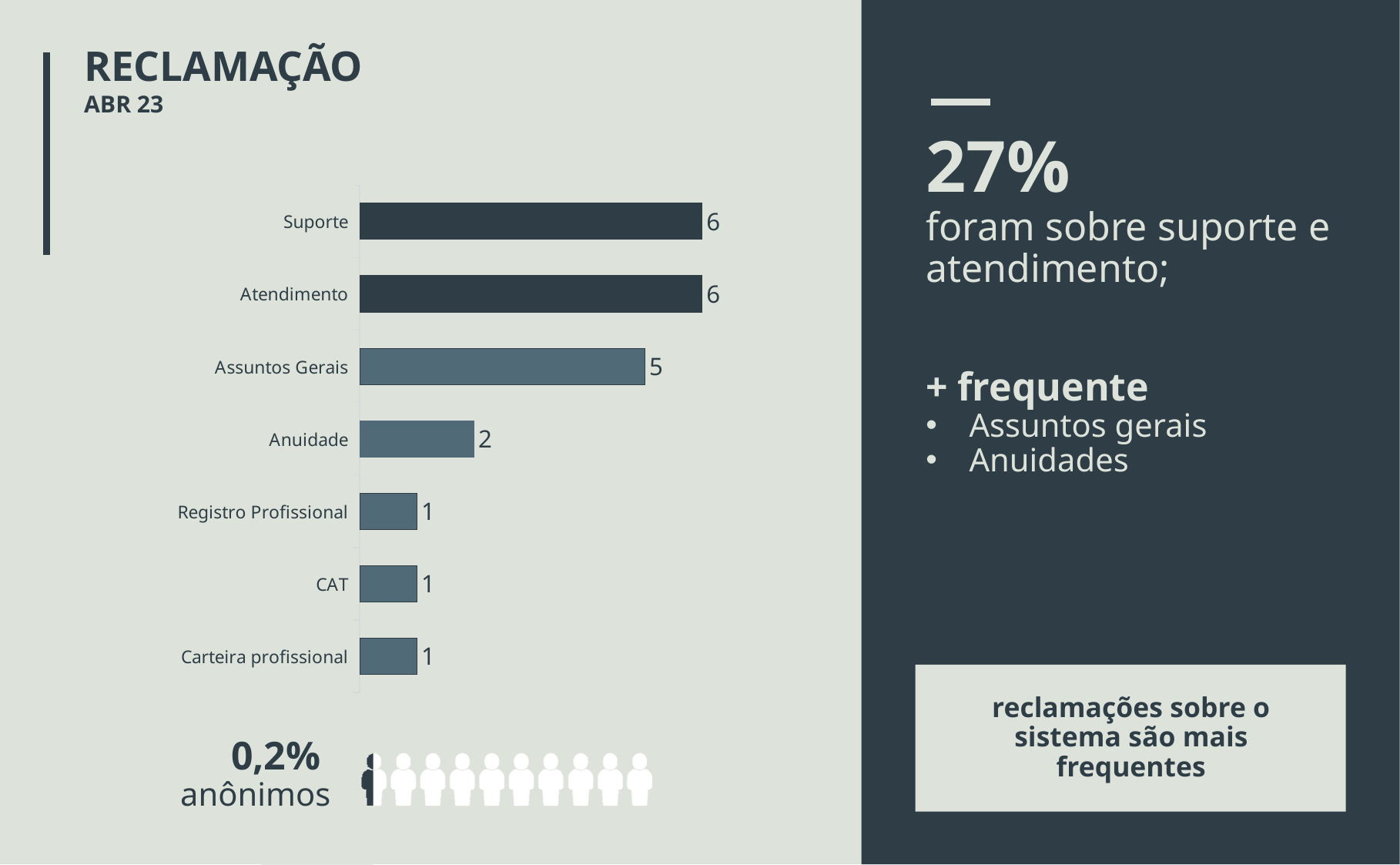
What is the value for Registro Profissional? 1 What is the difference between the values for Assuntos Gerais and Anuidade? 3 What is the lowest value shown in the chart? 1 How many categories are shown in the chart? 7 Which has a larger value, Anuidade or CAT? Anuidade What is the value for Suporte? 6 What kind of chart is shown on the slide? Bar chart What is the highest value shown in the chart? 6 What is the value for Assuntos Gerais? 5 What is the difference between the values for Atendimento and Assuntos Gerais? 1 What is the title of the slide containing the chart? RECLAMAÇÃO What is the value for Anuidade? 2